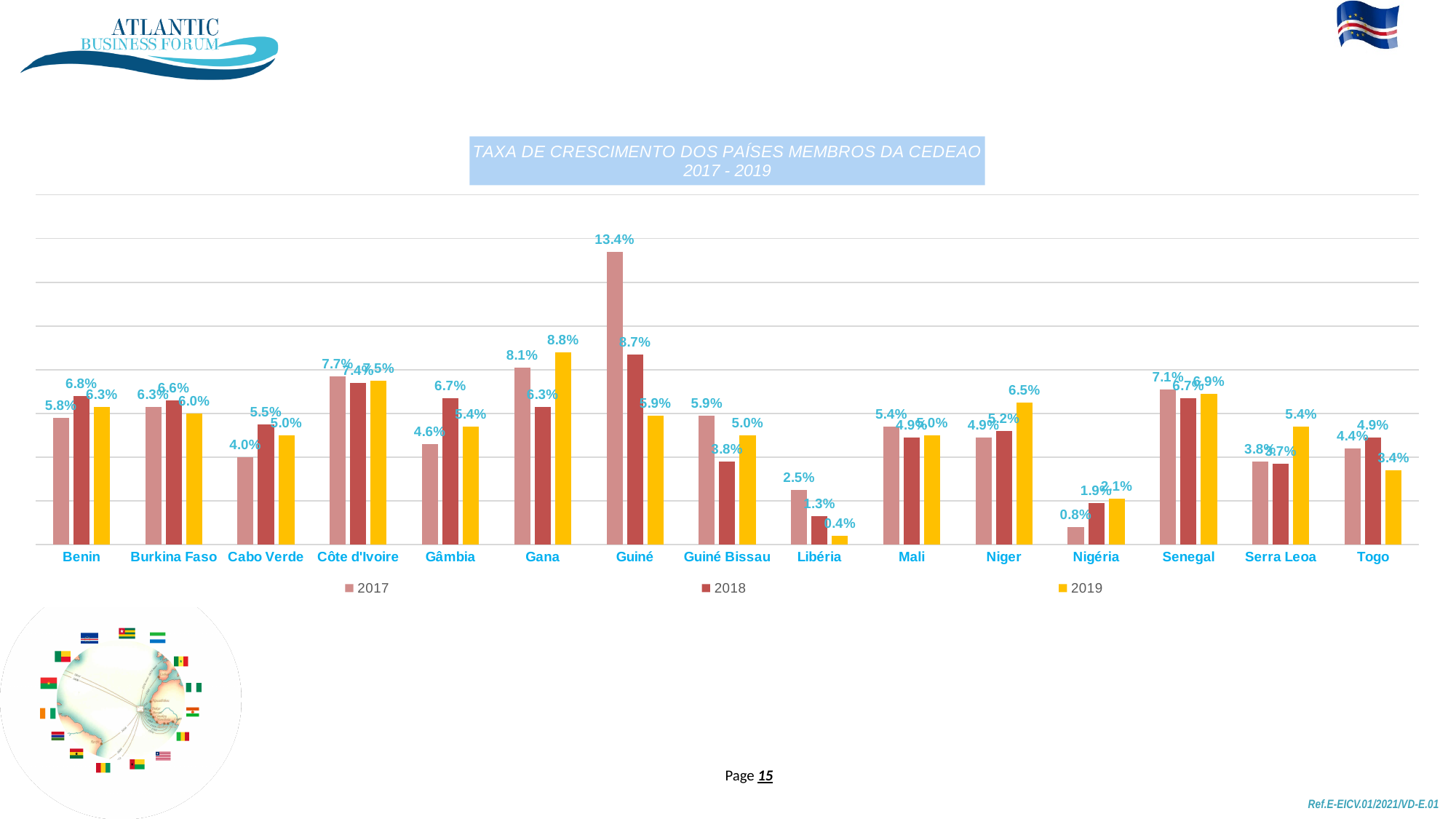
Which is larger: Gana's growth rate in 2019 or Guiné's growth rate in 2019? Gana's growth rate in 2019 What was the growth rate for Gana in 2019? 8.8% What kind of chart is shown on the slide? Bar chart What was the growth rate for Nigéria in 2017? 0.8% Which country had the lowest growth rate in 2019? Libéria What was the growth rate for Libéria in 2019? 0.4% How many countries are shown on the x axis of the chart? 15 Did Libéria's growth rate rise or fall from 2017 to 2019? Fall Which country had the highest growth rate in 2017? Guiné What was the growth rate for Guiné in 2017? 13.4% What is the difference between Guiné's growth rate in 2017 and in 2019? 7.5% How many series does the legend list? 3